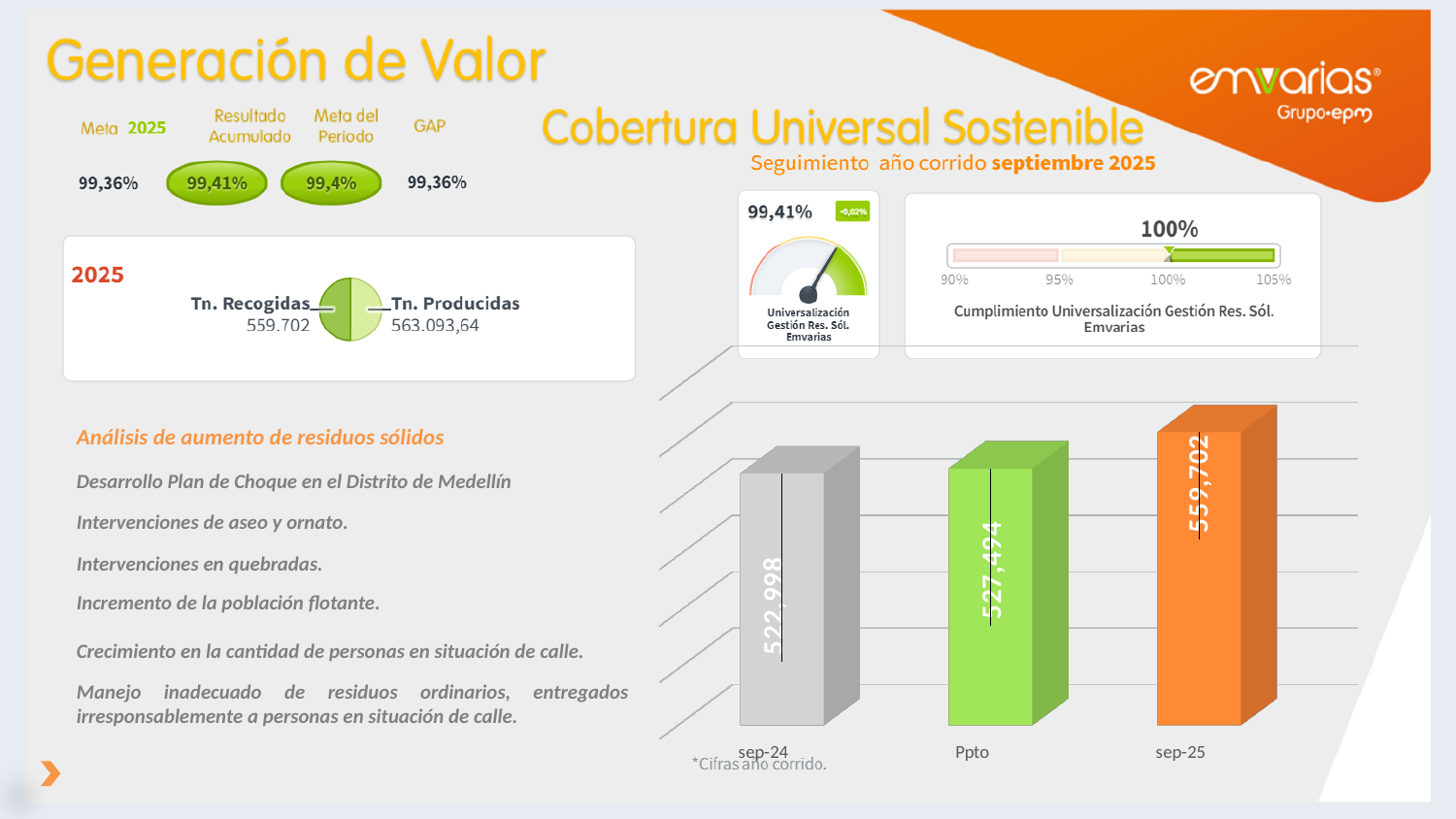
In the bar chart at the bottom right, what is the value for sep-25? 559,702 In the bar chart at the bottom right, what is the value for sep-24? 522,998 What value does the gauge chart labelled Universalización Gestión Res. Sól. Emvarias show? 99,41% In the bar chart at the bottom right, what is the difference between the sep-25 and sep-24 values? 36,704 In the bar chart at the bottom right, what is the difference between the sep-25 and Ppto values? 32,208 In the pie chart in the 2025 box, what is the value for Tn. Recogidas? 559.702 In the bar chart at the bottom right, which category has the lowest value? sep-24 In the pie chart in the 2025 box, what is the value for Tn. Producidas? 563.093,64 In the bar chart at the bottom right, what is the value for Ppto? 527,494 In the bar chart at the bottom right, which category has the highest value? sep-25 In the bar chart at the bottom right, how many bars are shown? 3 What kind of chart is shown at the bottom right of the slide? bar chart